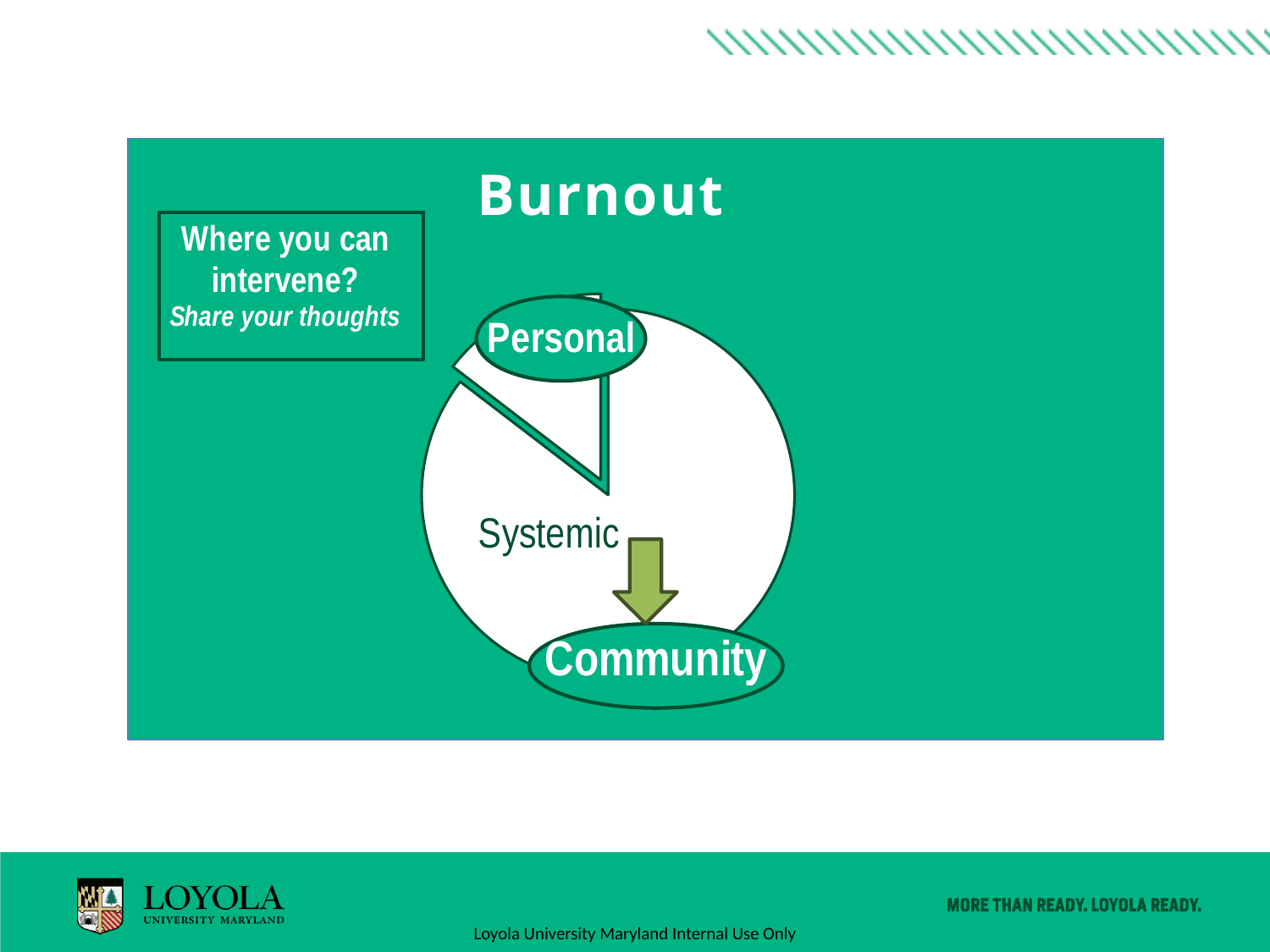
Which slice of the pie chart is the largest? Systemic What kind of chart is shown on the slide? pie chart Which slice of the pie chart is pulled out (exploded) from the rest of the pie? Personal Which slice is larger, Personal or Systemic? Systemic Which slice of the pie chart is the smallest? Personal What is the title of the chart? Burnout